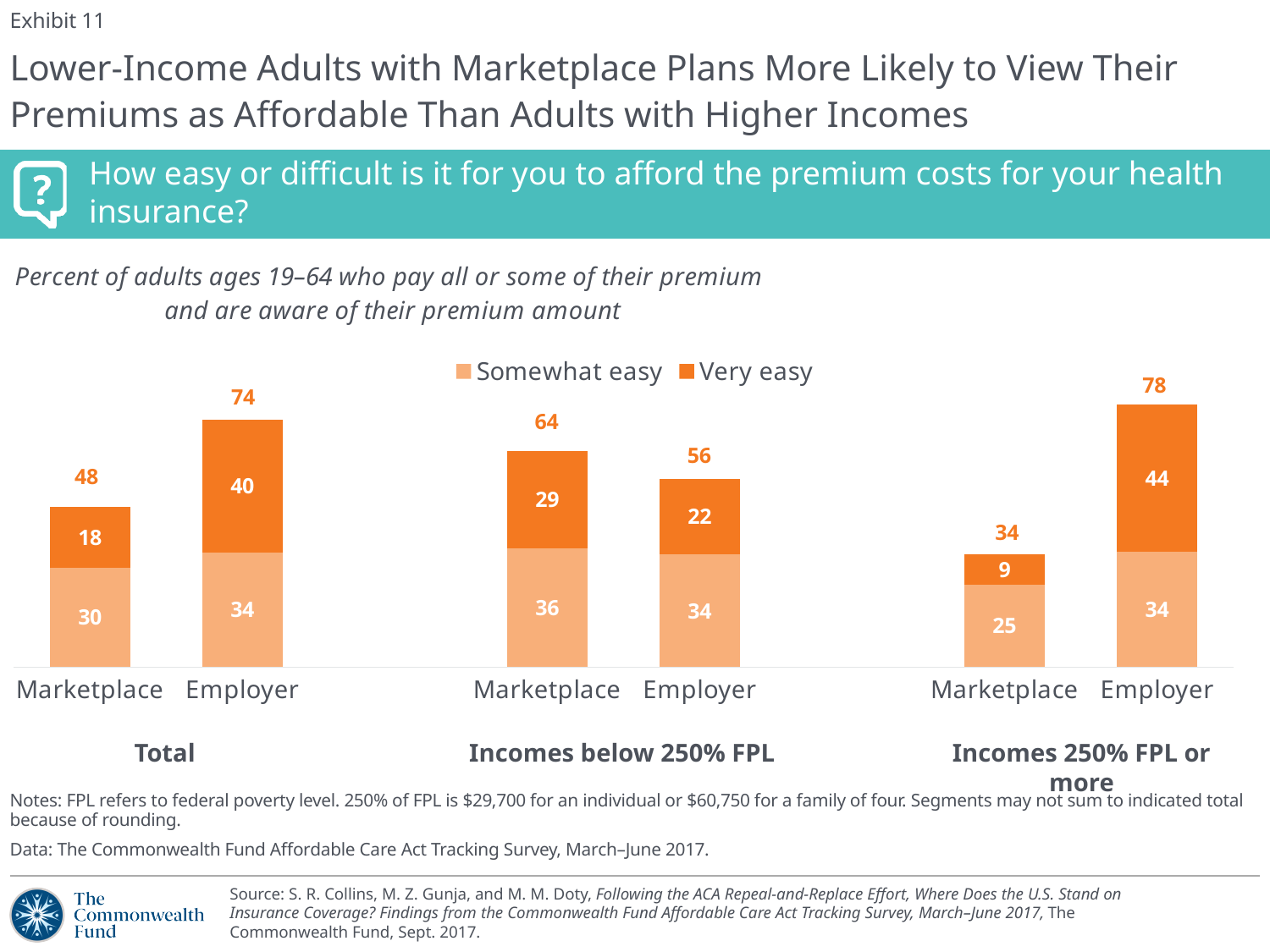
How many series does the legend list? 2 What is the "Very easy" value for Employer in the Incomes 250% FPL or more group? 44 What is the difference between the Employer total and the Marketplace total in the Total group? 26 Which bar has the highest total across the whole chart? Employer, Incomes 250% FPL or more What is the "Very easy" value for Marketplace in the Total group? 18 What kind of chart is shown on the slide? Stacked bar chart What is the total shown above the Marketplace bar in the Incomes below 250% FPL group? 64 What is the "Somewhat easy" value for Employer in the Incomes below 250% FPL group? 34 In the Incomes below 250% FPL group, which has the larger total, Marketplace or Employer? Marketplace How many bars are plotted in the chart? 6 Which bar has the lowest total across the whole chart? Marketplace, Incomes 250% FPL or more What is the total shown above the Marketplace bar in the Incomes 250% FPL or more group? 34